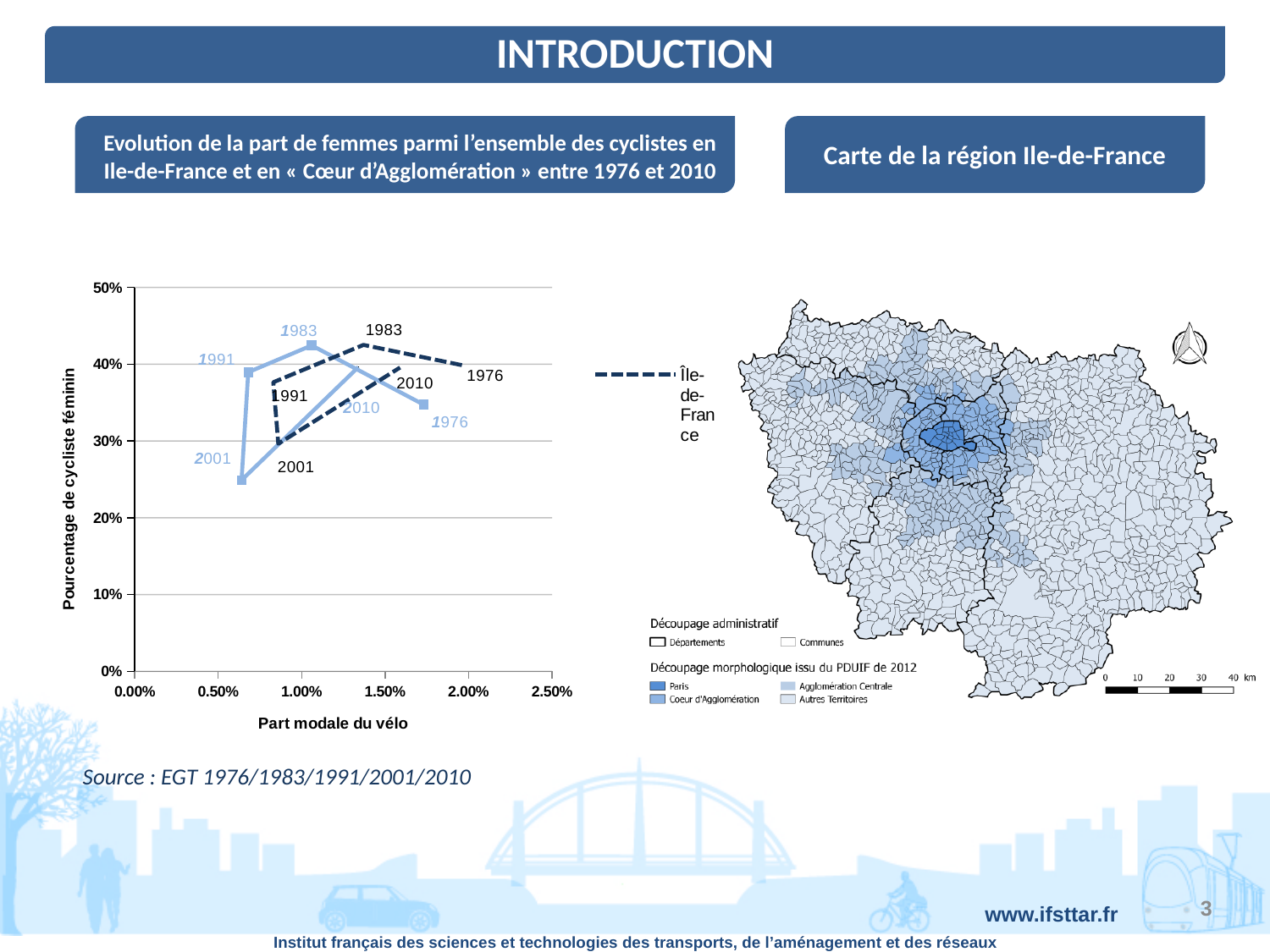
Is the percentage of female cyclists for 2001 in the light blue series greater or less than 30%? less For 2001, which series shows a higher percentage of female cyclists: the dashed Île-de-France series or the light blue series? the dashed Île-de-France series Which year has the lowest percentage of female cyclists in the light blue series? 2001 What is the title of the x axis of the chart? Part modale du vélo Which year has the highest percentage of female cyclists in the light blue series? 1983 Is the percentage of female cyclists for 1983 in the light blue series greater or less than 40%? greater What is the highest value shown on the y axis of the chart? 50% How many data points (years) are plotted for the dashed Île-de-France series? 5 What kind of chart is shown on the left of the slide? line chart What is the title of the y axis of the chart? Pourcentage de cycliste féminin Which year has the lowest percentage of female cyclists in the dashed Île-de-France series? 2001